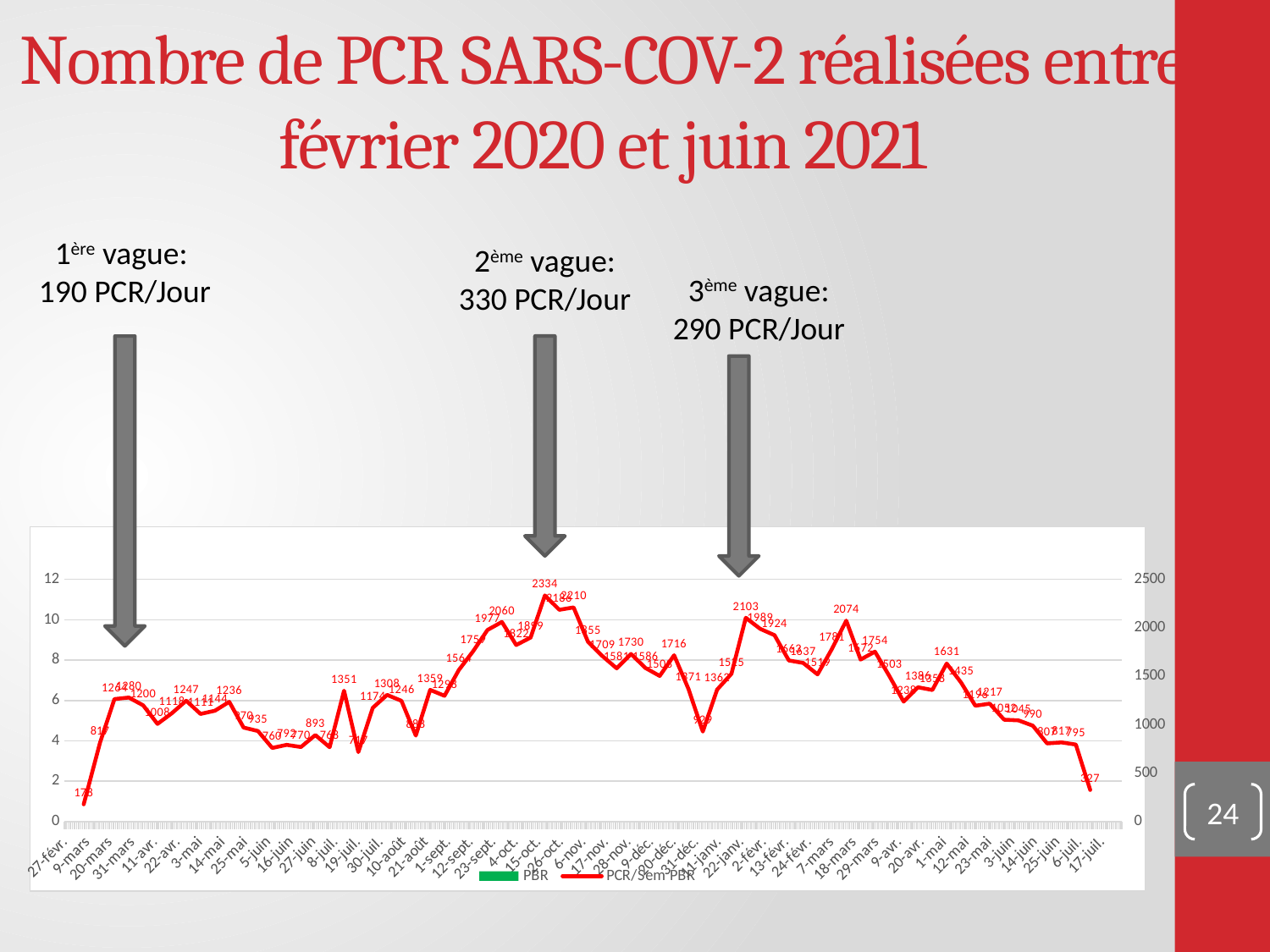
What is the value labelled at the first point of the line, near 27-févr.? 178 What is the difference between the peak labelled 2334 and the peak labelled 2103? 231 What is the highest value labelled on the PCR/Sem PBR line? 2334 Which is larger, the peak labelled 2334 or the later peak labelled 2074? 2334 Is the highest point of the line greater or less than 2000 on the right-hand axis? greater What is the maximum value shown on the right-hand vertical axis? 2500 What kind of chart is shown on the slide? line chart What is the value labelled at the last point of the line, near 17-juil.? 327 What are the two entries in the chart legend? PBR and PCR/Sem PBR Does the line rise or fall between the peak around 26-oct. and the end of the chart at 17-juil.? fall According to the annotation, how many PCR per day were done during the 2ème vague? 330 PCR/Jour How many series does the legend list? 2